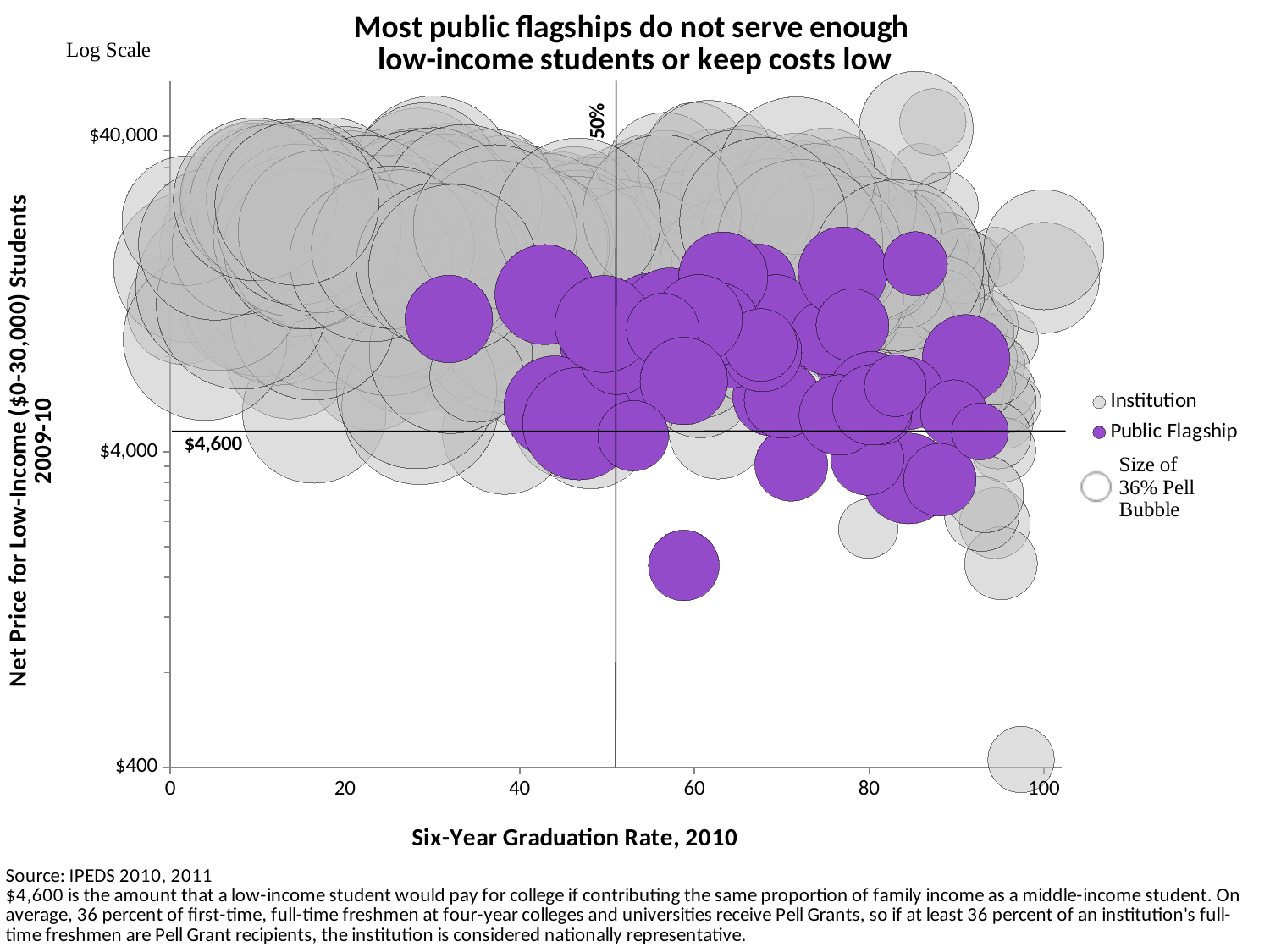
Is the net price for the lowest Public Flagship bubble greater or less than $4,000? less Is the net price for the Institution bubble at the bottom right of the chart (near a 100 graduation rate) greater or less than $4,000? less How many data series does the legend list (excluding the bubble size key)? 2 What is the title of the chart? Most public flagships do not serve enough low-income students or keep costs low What kind of chart is shown on the slide? Bubble chart What colour are the Public Flagship bubbles? Purple Is the six-year graduation rate for the leftmost Public Flagship bubble greater or less than 40? less